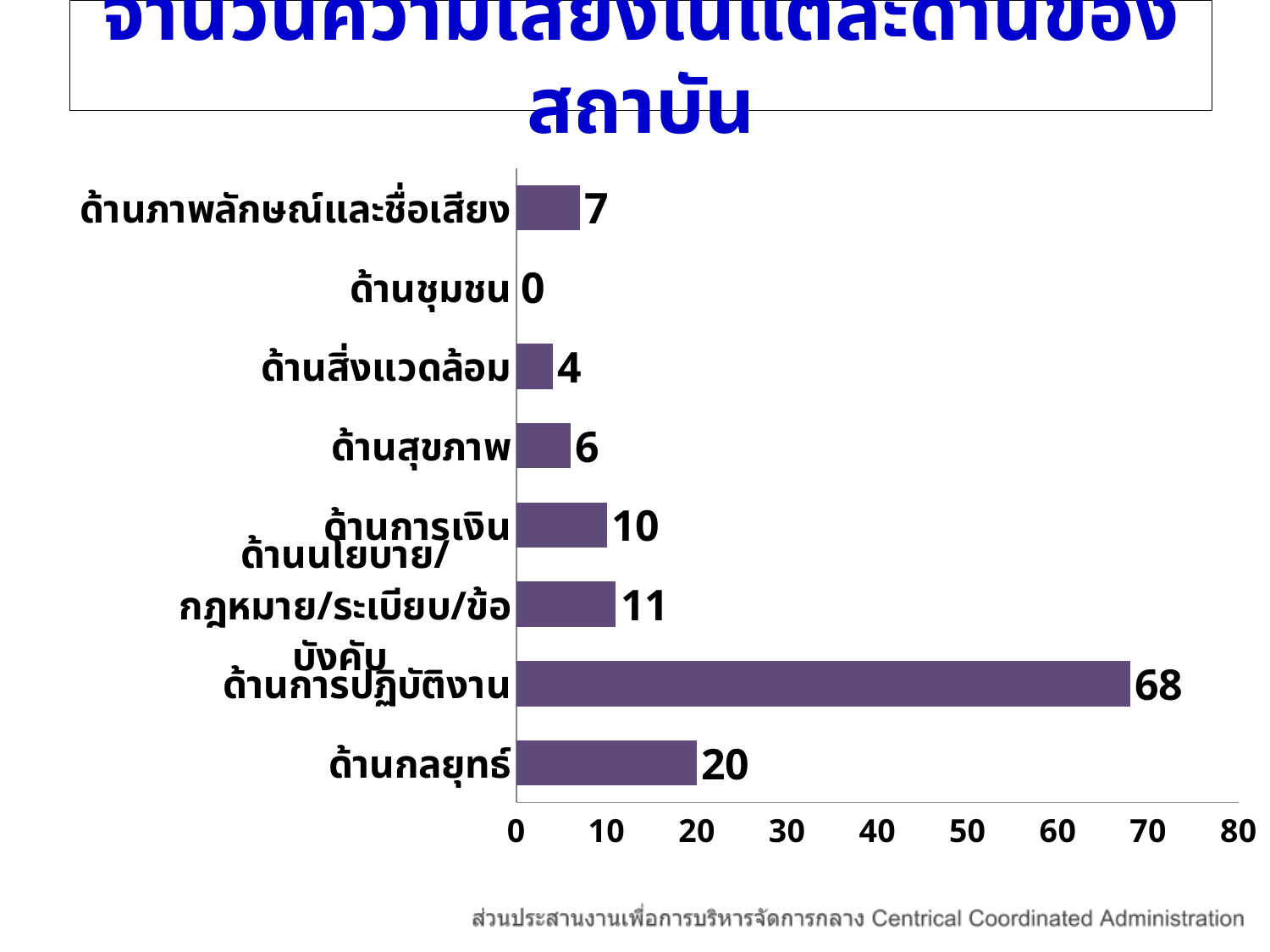
How many categories are shown in the chart? 8 Is the value for ด้านการปฏิบัติงาน greater or less than 60? greater Which category has the highest value? ด้านการปฏิบัติงาน What is the value for ด้านการปฏิบัติงาน? 68 Which is larger, the value for ด้านการเงิน or the value for ด้านสุขภาพ? ด้านการเงิน What is the difference between the values for ด้านการปฏิบัติงาน and ด้านกลยุทธ์? 48 What kind of chart is shown on the slide? bar chart What is the value for ด้านกลยุทธ์? 20 Which category has the lowest value? ด้านชุมชน What is the maximum value shown on the horizontal axis? 80 What is the value for ด้านชุมชน? 0 What is the value for ด้านสิ่งแวดล้อม? 4